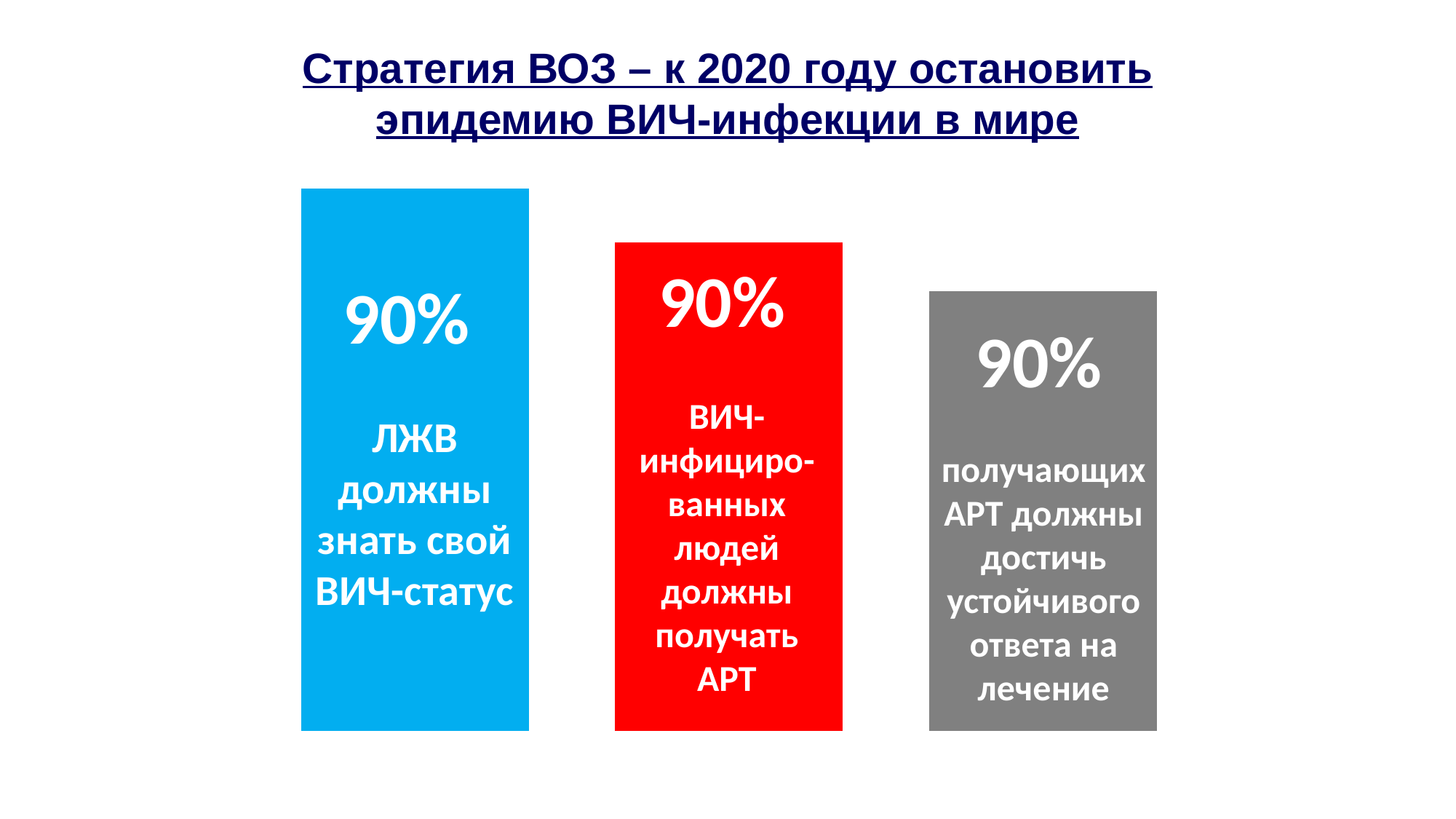
What kind of chart is shown on the slide? bar chart What colour is the bar labelled 'ВИЧ-инфицированных людей должны получать АРТ'? red How many bars are shown on the slide? 3 What value is shown in the blue bar for people living with HIV who should know their HIV status (ЛЖВ должны знать свой ВИЧ-статус)? 90% What value is shown in the grey bar for people receiving ART who should achieve a sustained treatment response (получающих АРТ должны достичь устойчивого ответа на лечение)? 90% What is the title of the slide? Стратегия ВОЗ – к 2020 году остановить эпидемию ВИЧ-инфекции в мире What value is shown in the red bar for HIV-infected people who should receive ART (ВИЧ-инфицированных людей должны получать АРТ)? 90% Is the value shown in the grey bar greater or less than 50%? greater What is the difference between the value in the blue bar and the value in the red bar? 0%